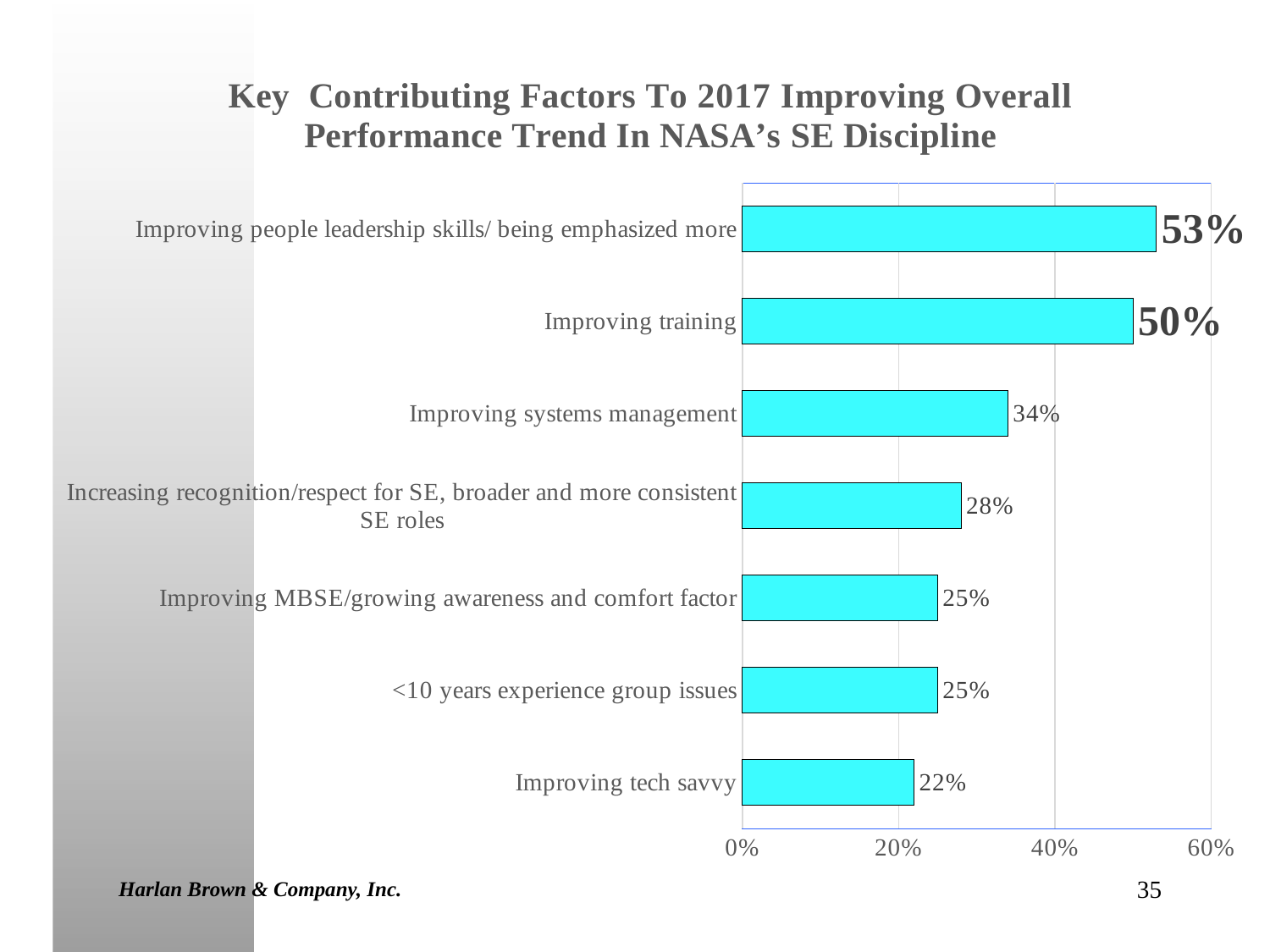
Is the value for "Improving systems management" greater or less than 40%? less Which is larger, the value for "Increasing recognition/respect for SE, broader and more consistent SE roles" or the value for "Improving tech savvy"? Increasing recognition/respect for SE, broader and more consistent SE roles What is the difference between the values for "Improving training" and "Improving systems management"? 16% Which category has the highest value? Improving people leadership skills/ being emphasized more What is the title of the chart? Key Contributing Factors To 2017 Improving Overall Performance Trend In NASA's SE Discipline How many categories are shown in the chart? 7 What kind of chart is shown on the slide? bar chart What is the value for "Improving systems management"? 34% What is the value for "Improving tech savvy"? 22% Which category has the lowest value? Improving tech savvy What is the value for "Improving training"? 50% What is the value for "Improving people leadership skills/ being emphasized more"? 53%